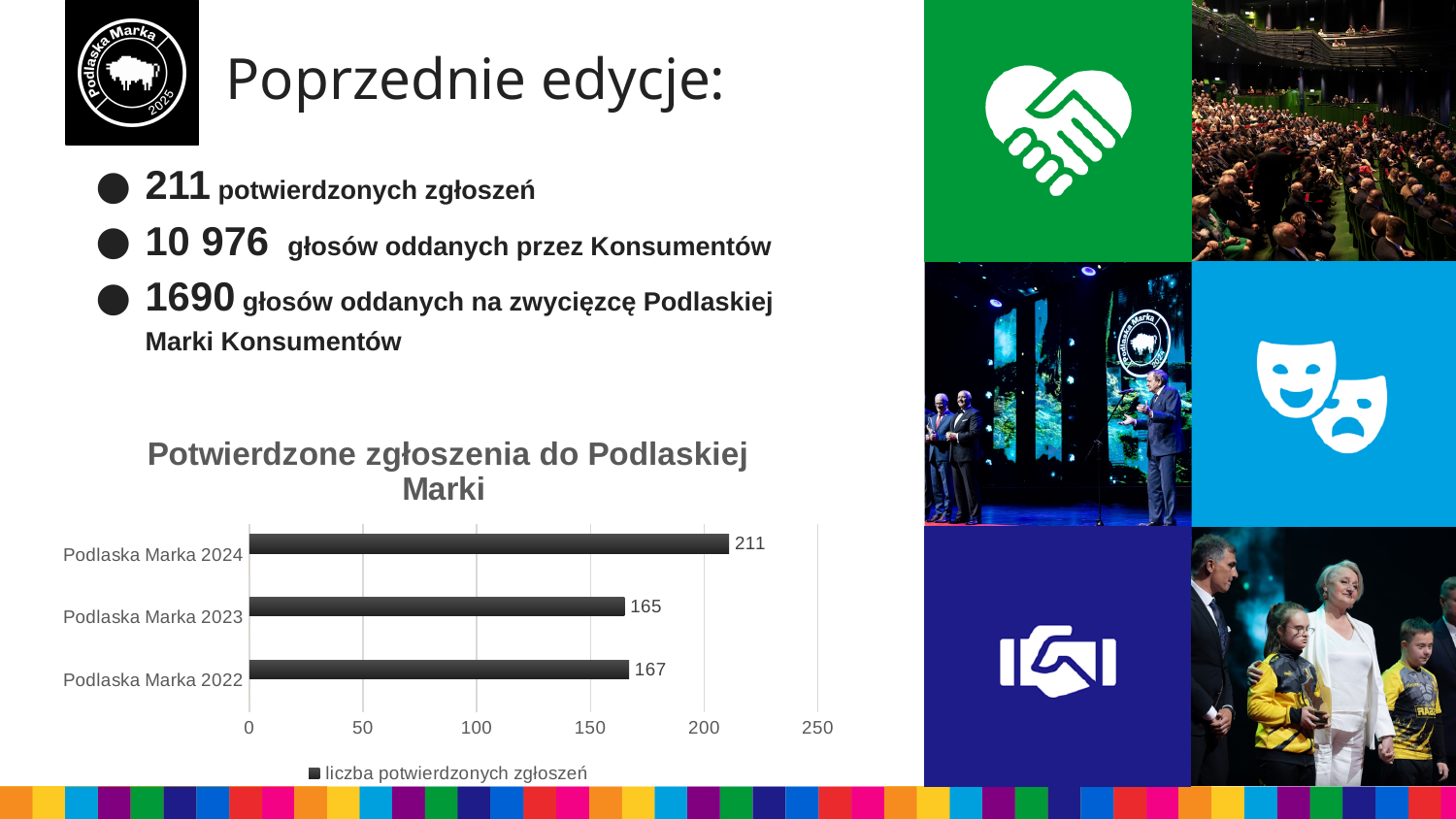
What kind of chart is shown on the slide? bar chart How many categories are shown in the chart? 3 Which is larger, the value for Podlaska Marka 2024 or Podlaska Marka 2022? Podlaska Marka 2024 What is the title of the chart? Potwierdzone zgłoszenia do Podlaskiej Marki What is the difference between the values for Podlaska Marka 2024 and Podlaska Marka 2023? 46 Is the value for Podlaska Marka 2024 greater or less than 200? greater What is the difference between the values for Podlaska Marka 2022 and Podlaska Marka 2023? 2 Which category has the highest value? Podlaska Marka 2024 Which category has the lowest value? Podlaska Marka 2023 What is the value for Podlaska Marka 2022? 167 What is the value for Podlaska Marka 2024? 211 What is the value for Podlaska Marka 2023? 165